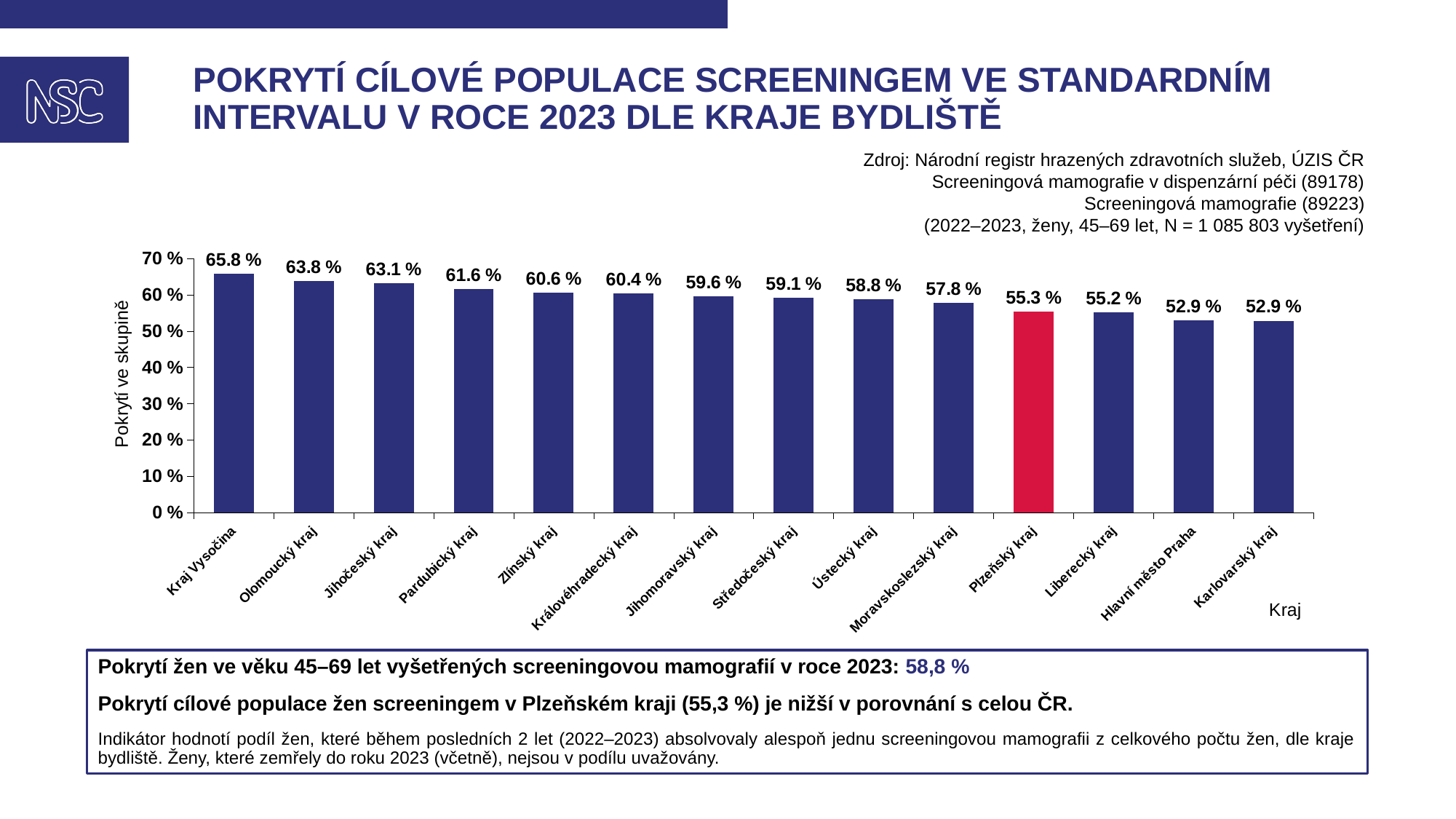
Do the values rise or fall from left to right along the x axis? Fall What is the value for Hlavní město Praha? 52.9 % Which region has the highest value? Kraj Vysočina What is the difference between the values for Kraj Vysočina and Karlovarský kraj? 12.9 % Which is larger, the value for Zlínský kraj or the value for Jihomoravský kraj? Zlínský kraj What kind of chart is shown on the slide? Bar chart Which region's bar is highlighted in red? Plzeňský kraj How many regions are shown on the x axis? 14 What is the value for Středočeský kraj? 59.1 % What is the difference between the values for Olomoucký kraj and Jihočeský kraj? 0.7 % What is the value for Plzeňský kraj? 55.3 % What is the value for Kraj Vysočina? 65.8 %